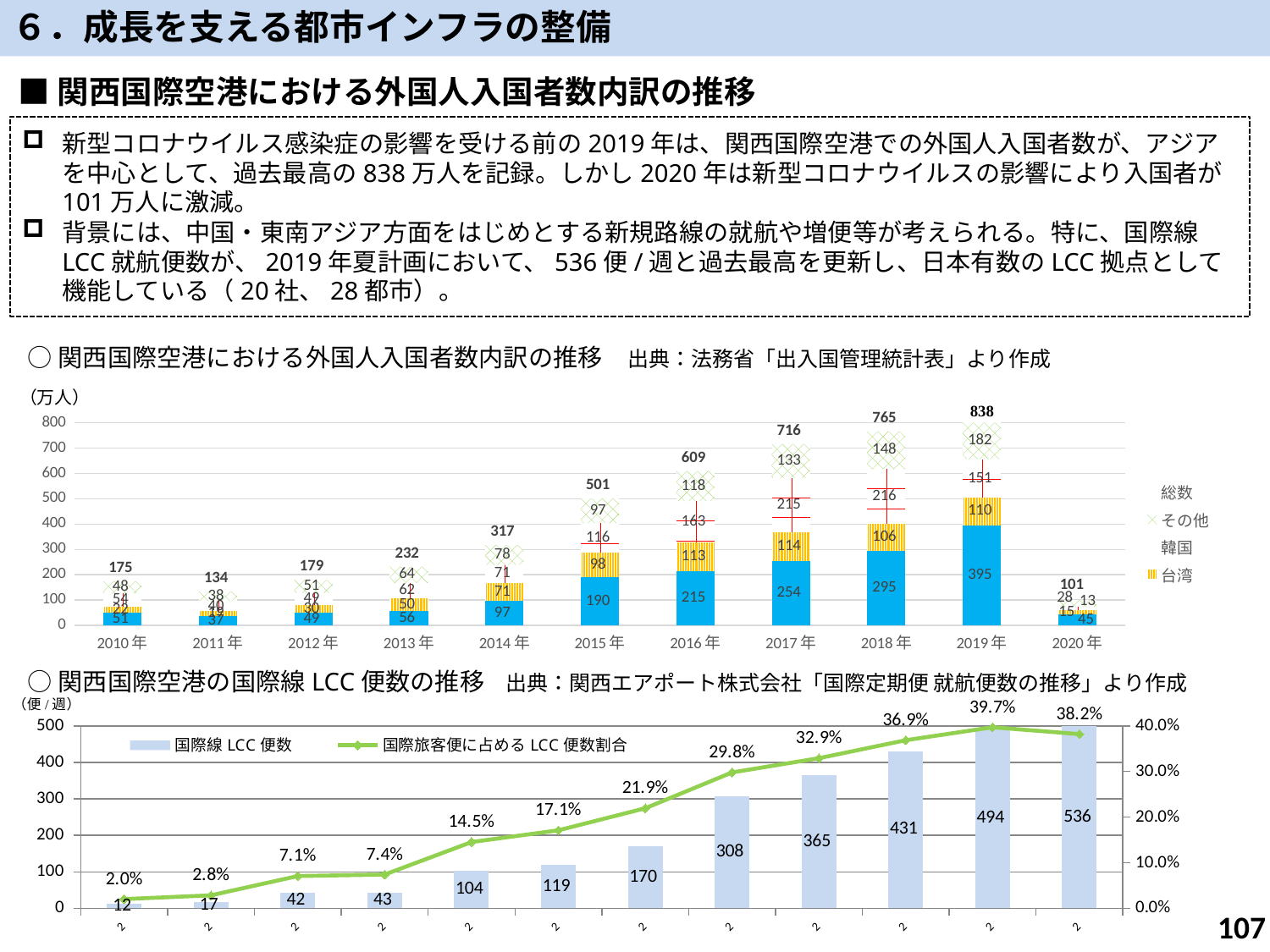
In the bottom chart (関西国際空港の国際線LCC便数の推移), what is the highest value of 国際旅客便に占めるLCC便数割合 shown? 39.7% In the bottom chart (関西国際空港の国際線LCC便数の推移), how many series does the legend list? 2 In the top chart (関西国際空港における外国人入国者数内訳の推移), which year has the highest total? 2019年 In the top chart (関西国際空港における外国人入国者数内訳の推移), how many years are shown on the x axis? 11 In the top chart (関西国際空港における外国人入国者数内訳の推移), what is the total (総数) for 2020年? 101 In the top chart (関西国際空港における外国人入国者数内訳の推移), which year has the lowest total? 2020年 In the top chart (関西国際空港における外国人入国者数内訳の推移), what is the difference between the totals for 2019年 and 2018年? 73 In the bottom chart (関西国際空港の国際線LCC便数の推移), what is the highest value of 国際線LCC便数 shown? 536 In the top chart (関西国際空港における外国人入国者数内訳の推移), what is the value for 台湾 in 2019年? 110 What kind of chart is the top chart (関西国際空港における外国人入国者数内訳の推移)? Stacked bar chart In the top chart (関西国際空港における外国人入国者数内訳の推移), what is the total (総数) for 2019年? 838 In the top chart (関西国際空港における外国人入国者数内訳の推移), which total is larger, 2016年 or 2017年? 2017年